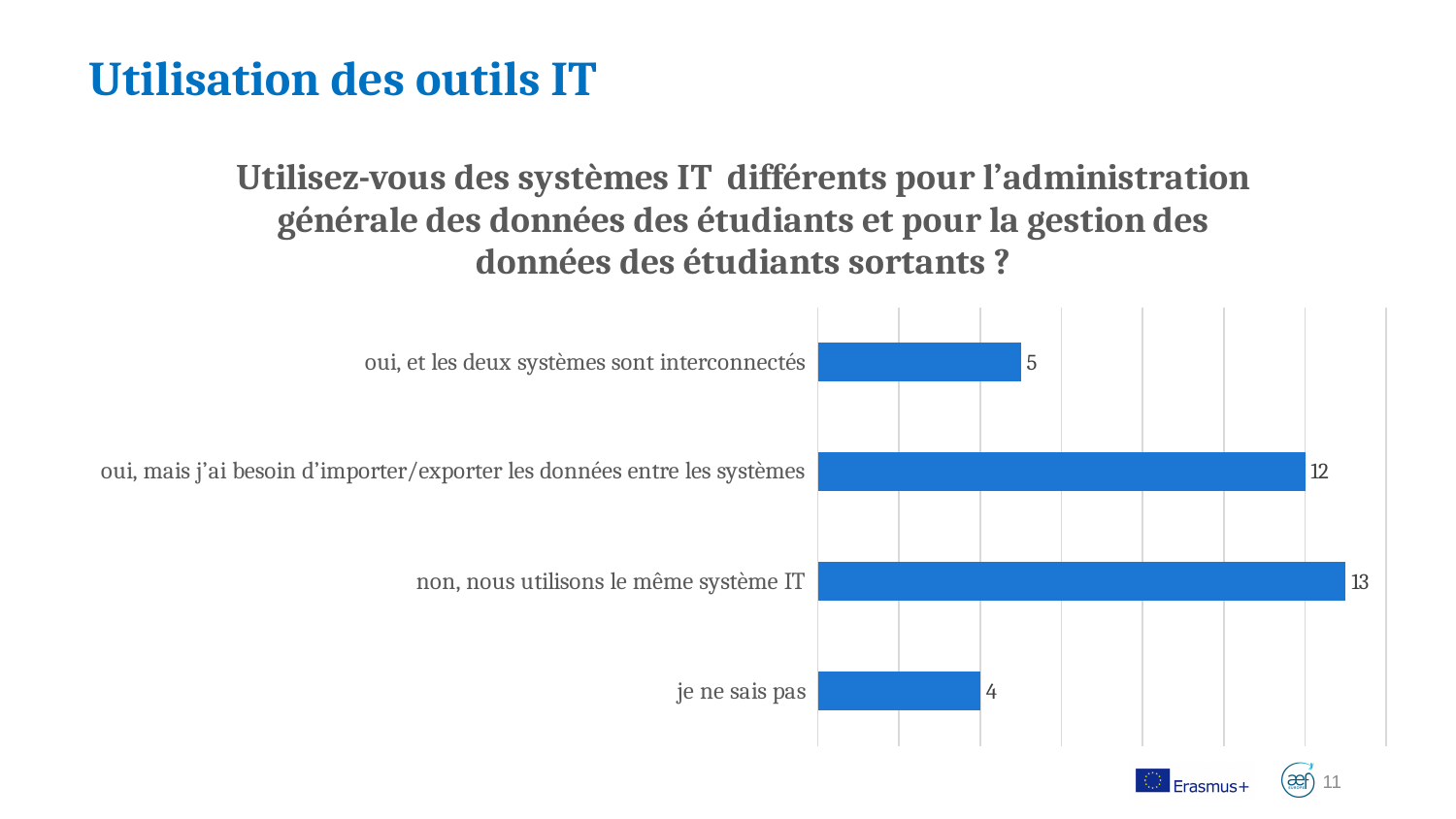
What is the title of the slide? Utilisation des outils IT What is the value for "oui, mais j'ai besoin d'importer/exporter les données entre les systèmes"? 12 What is the value for "oui, et les deux systèmes sont interconnectés"? 5 How many categories are shown in the chart? 4 What is the difference between the values for "oui, et les deux systèmes sont interconnectés" and "je ne sais pas"? 1 Which category has the highest value? non, nous utilisons le même système IT What is the difference between the values for "non, nous utilisons le même système IT" and "oui, mais j'ai besoin d'importer/exporter les données entre les systèmes"? 1 Which is larger: the value for "oui, et les deux systèmes sont interconnectés" or the value for "je ne sais pas"? oui, et les deux systèmes sont interconnectés Which category has the lowest value? je ne sais pas What kind of chart is shown on the slide? bar chart What is the value for "je ne sais pas"? 4 What is the value for "non, nous utilisons le même système IT"? 13